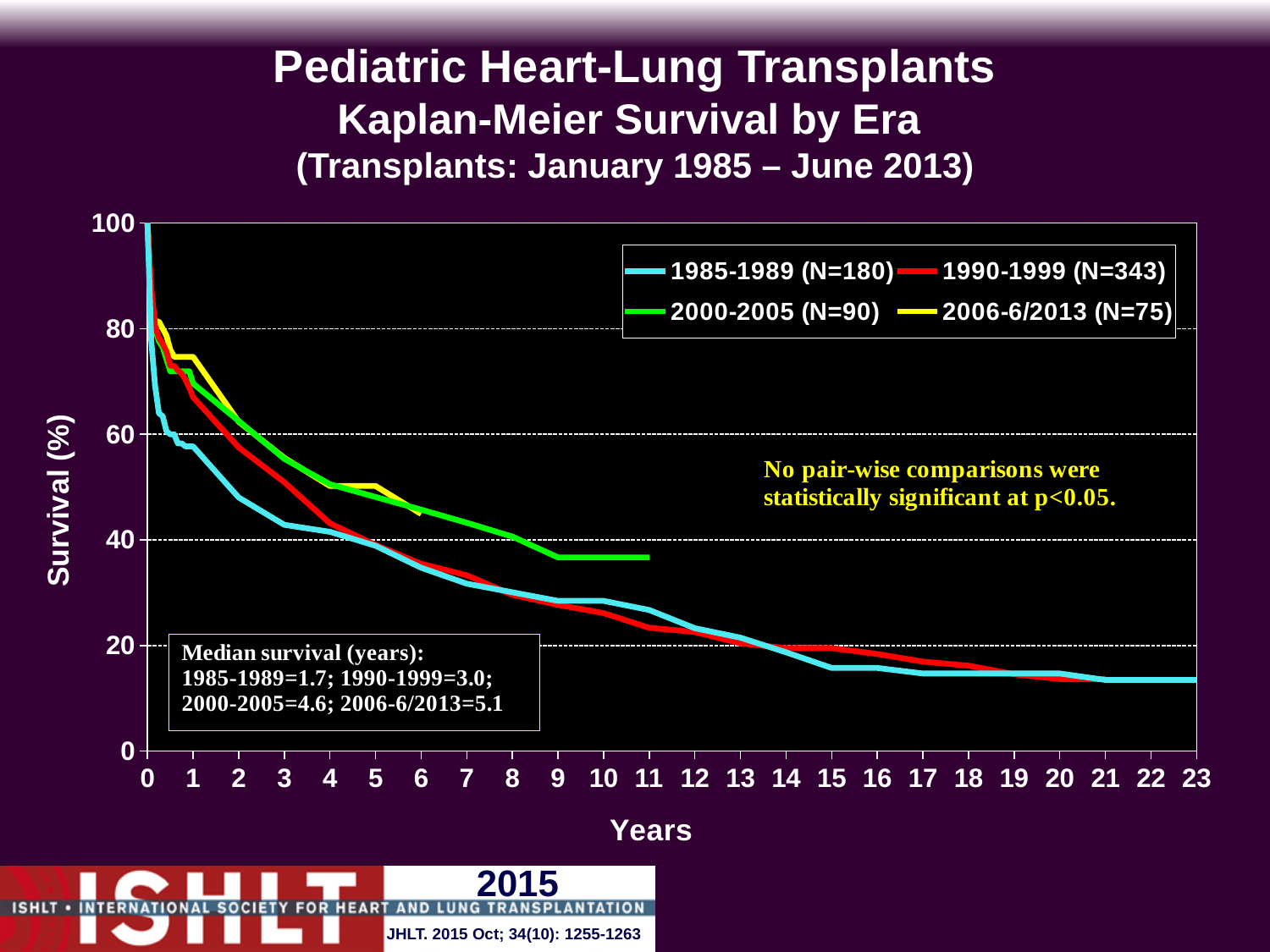
According to the text box, what is the median survival in years for the 1985-1989 era? 1.7 What is the difference in median survival (years) between the 2000-2005 era and the 1990-1999 era? 1.6 Is the survival value for the 2000-2005 era at 5 years greater or less than 60? less What is the N shown in the legend for the 1990-1999 era? 343 Which era has the lowest median survival according to the text box? 1985-1989 Is the survival value for the 1990-1999 era at 20 years greater or less than 20? less What kind of chart is shown on the slide? line chart Do the survival curves rise or fall as the years increase? fall How many series does the legend list? 4 According to the text box, what is the median survival in years for the 2006-6/2013 era? 5.1 Which era has the highest median survival according to the text box? 2006-6/2013 Is the survival value for the 1985-1989 era at 10 years greater or less than 40? less